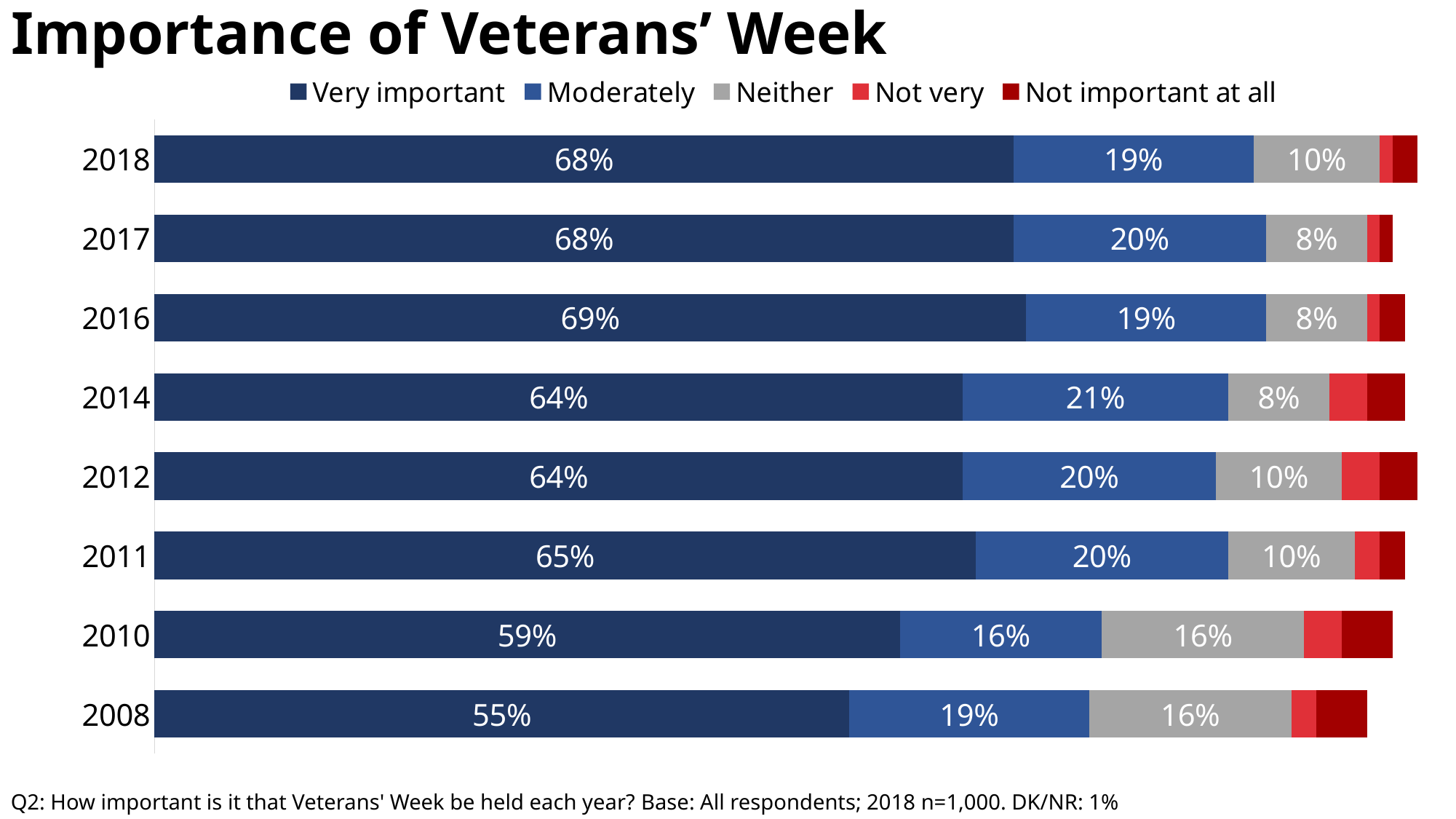
Which year has the highest Very important percentage? 2016 What percentage of respondents said Veterans' Week was Very important in 2018? 68% How many series does the legend list? 5 How many years are shown in the chart? 8 What is the Very important value for 2008? 55% Does the Very important share rise or fall from 2008 to 2018? Rises What kind of chart is shown on the slide? Stacked bar chart What is the Moderately value for 2014? 21% Which year has the larger Moderately value, 2014 or 2010? 2014 By how many percentage points does the Very important share in 2018 exceed that in 2008? 13 percentage points What is the Neither value for 2010? 16% Which year has the lowest Very important percentage? 2008